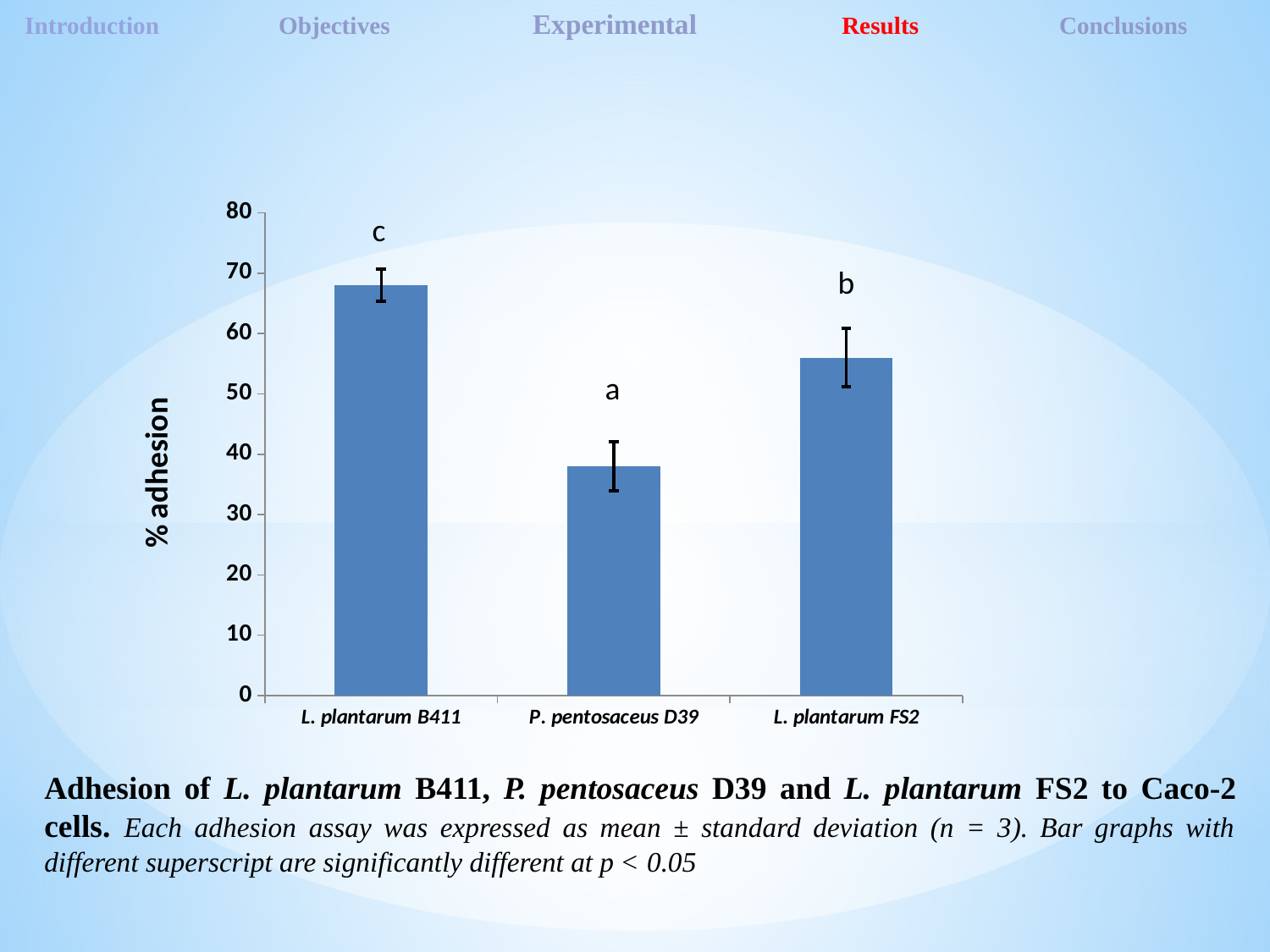
Is the % adhesion for L. plantarum FS2 greater or less than 50? greater What superscript letter is shown above the bar for P. pentosaceus D39? a Is the % adhesion for L. plantarum B411 greater or less than 60? greater How many bacterial strains are plotted in the chart? 3 Which strain has the lowest % adhesion? P. pentosaceus D39 Is the % adhesion for P. pentosaceus D39 greater or less than 40? less What is the label on the y axis of the chart? % adhesion Which has a higher % adhesion, L. plantarum FS2 or P. pentosaceus D39? L. plantarum FS2 What kind of chart is shown on the slide? bar chart Which has a higher % adhesion, L. plantarum B411 or L. plantarum FS2? L. plantarum B411 Which strain has the highest % adhesion? L. plantarum B411